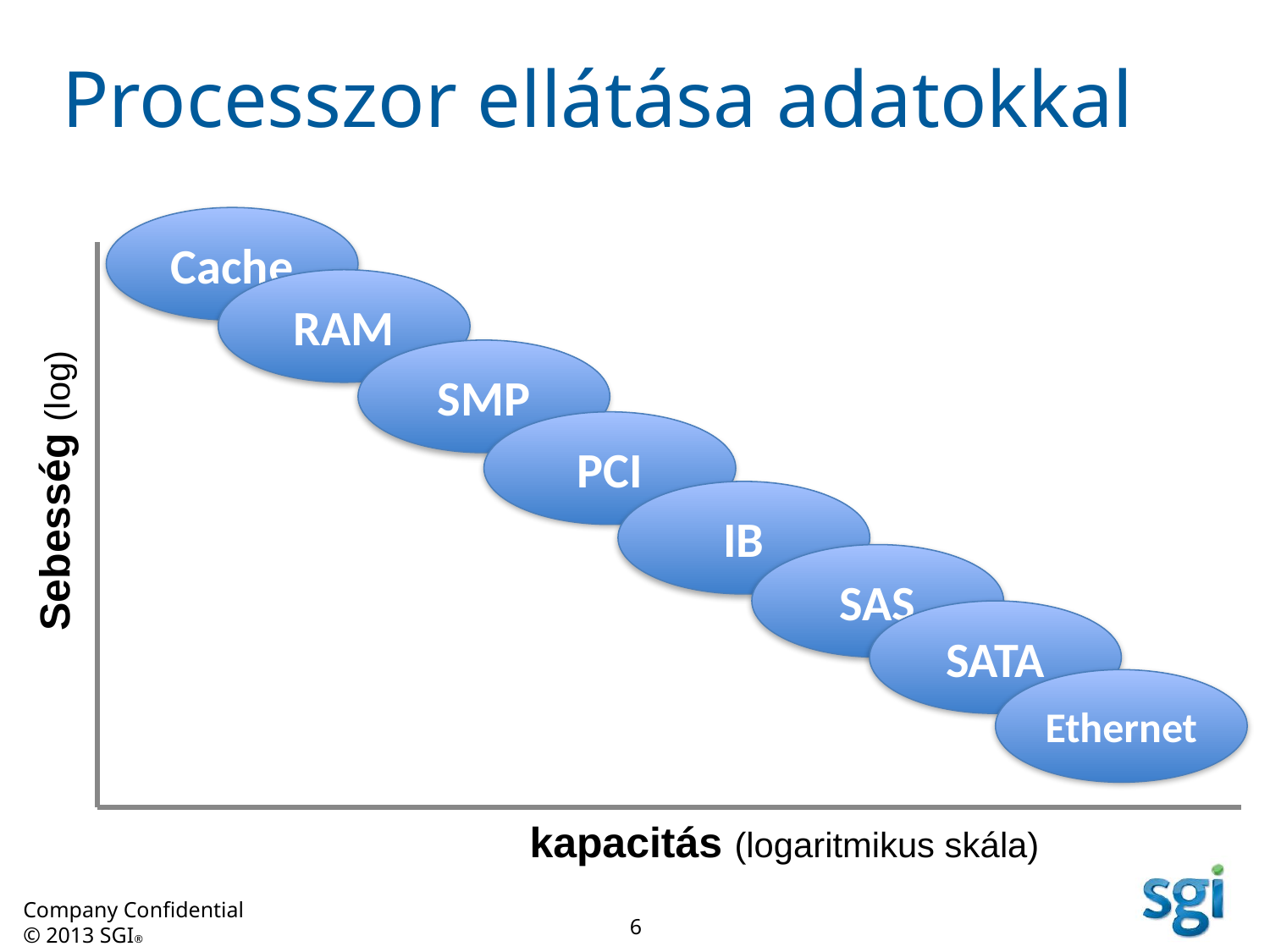
Which item lies between PCI and SAS along the chart? IB How many labelled items (ellipses) are plotted on the chart? 8 Which item is plotted with the lowest speed (Sebesség)? Ethernet Which item is plotted with the highest speed (Sebesség)? Cache Which is plotted with higher speed, RAM or PCI? RAM Which item is plotted immediately after SATA in order of increasing capacity? Ethernet What is the label of the horizontal axis? kapacitás (logaritmikus skála) Which item is plotted with the largest capacity (kapacitás)? Ethernet As capacity increases along the x axis, does speed rise or fall? fall Which item is plotted with the smallest capacity (kapacitás)? Cache What is the label of the vertical axis? Sebesség (log) Which is plotted with greater capacity, SAS or SMP? SAS